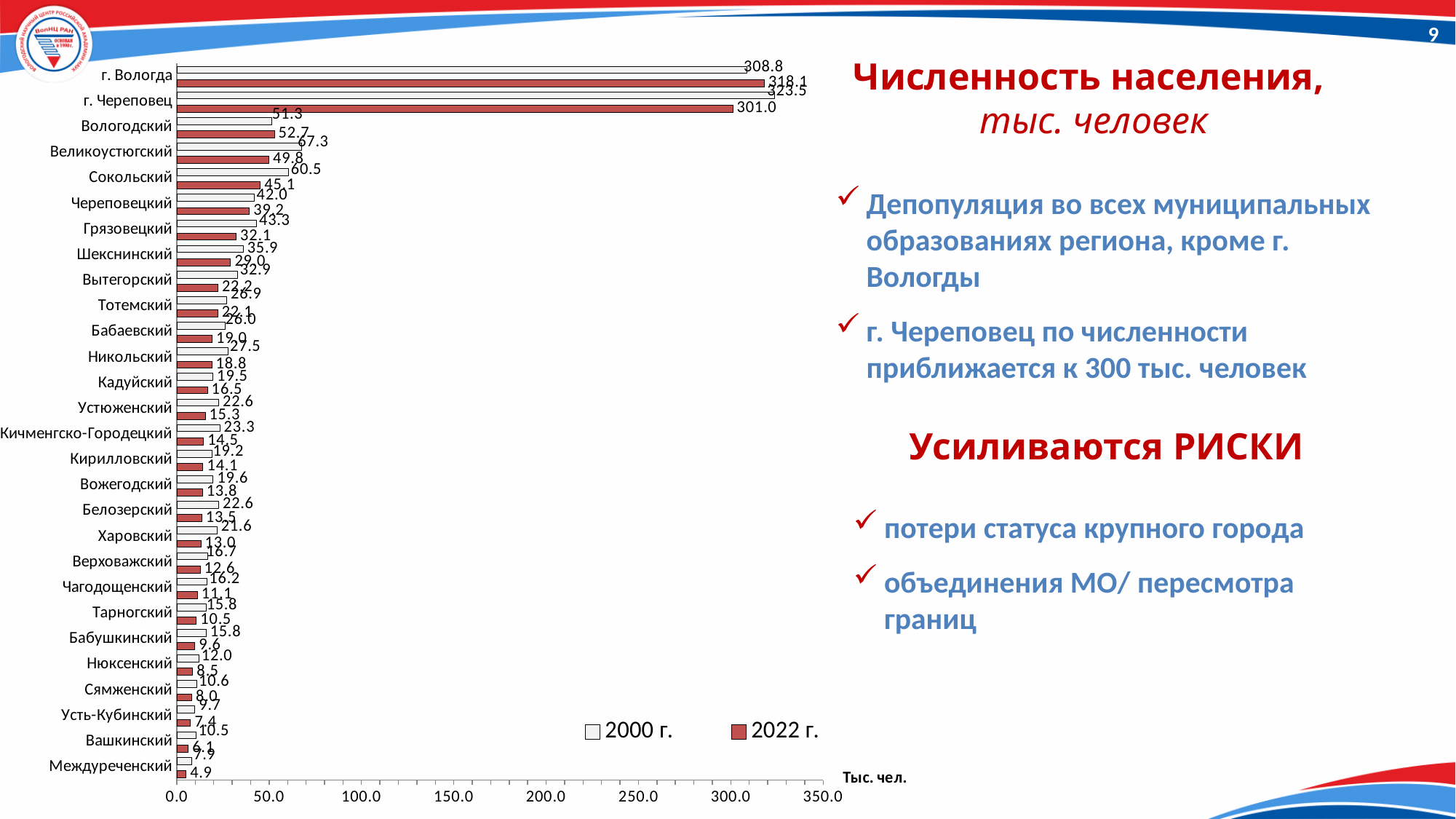
What is the value for Великоустюгский in 2022 г.? 49.8 What is the population of г. Череповец in 2000 г.? 323.5 What is the value for Междуреченский in 2022 г.? 4.9 Which category has the highest value in the 2000 г. series? г. Череповец Which is larger: the 2022 г. value for г. Вологда or the 2022 г. value for г. Череповец? г. Вологда Is the 2000 г. value for Сокольский greater or less than 50.0? greater How many series does the legend list? 2 What type of chart is shown on the slide? bar chart By how much did the population of г. Череповец change from 2000 г. (323.5) to 2022 г. (301.0)? 22.5 Which category has the lowest value in the 2022 г. series? Междуреченский What is the population of г. Вологда in 2022 г.? 318.1 How many categories are shown on the chart? 28